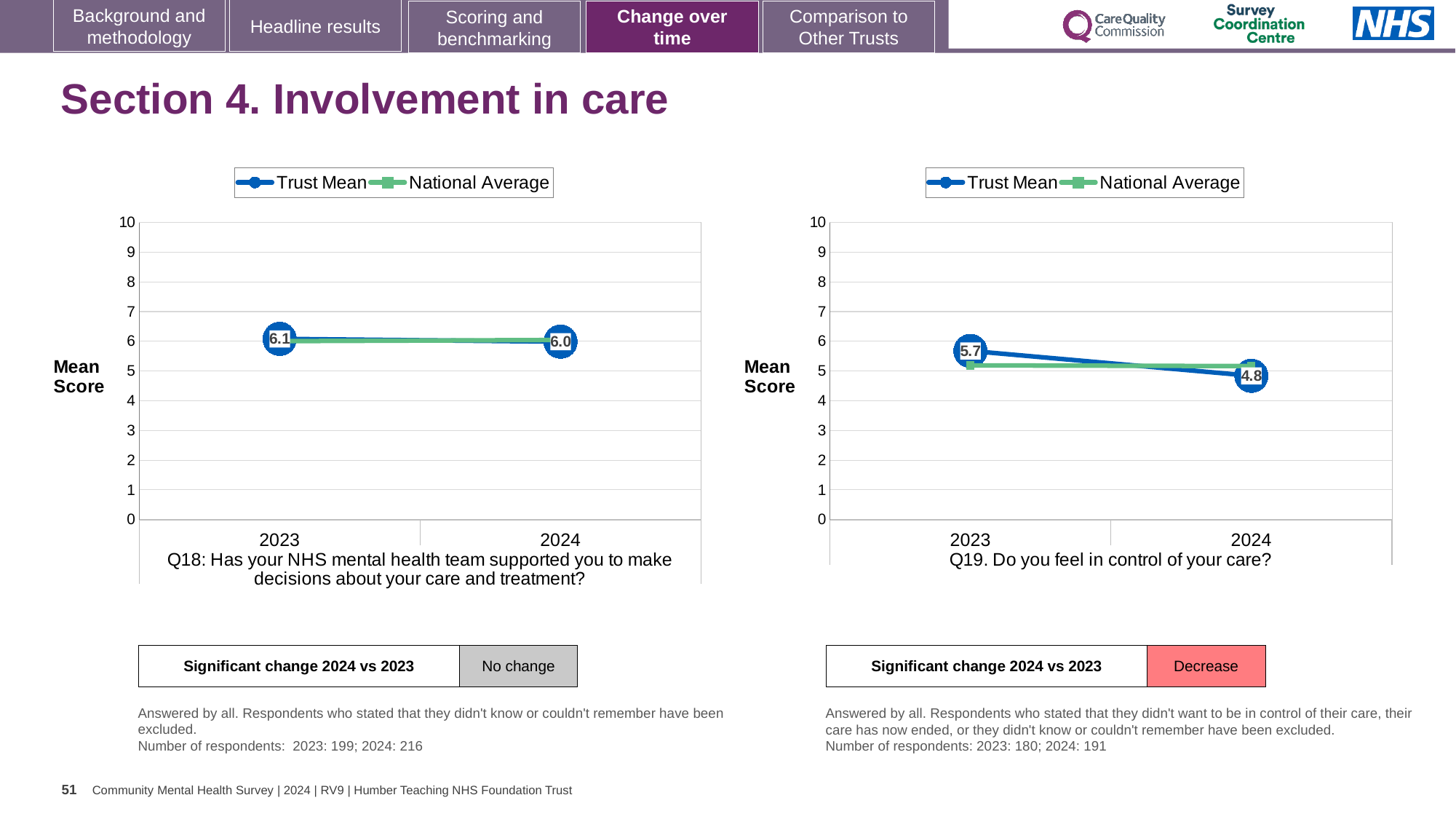
In the Q19 chart on the right, what is the Trust Mean for 2023? 5.7 In the Q19 chart on the right, which year has the higher Trust Mean, 2023 or 2024? 2023 In the Q18 chart on the left, what is the difference between the Trust Mean in 2023 and in 2024? 0.1 In the Q18 chart on the left, what is the Trust Mean for 2023? 6.1 In the Q19 chart on the right, what is the Trust Mean for 2024? 4.8 How many years are shown on the x axis of the Q18 chart on the left? 2 In the Q19 chart on the right, by how much did the Trust Mean fall from 2023 to 2024? 0.9 How many series does the legend of the Q19 chart on the right list? 2 What kind of chart is the Q18 chart on the left? line chart In the Q18 chart on the left, what is the Trust Mean for 2024? 6.0 In the Q19 chart on the right, is the Trust Mean for 2024 greater or less than 5? less In the Q19 chart on the right, does the Trust Mean rise or fall from 2023 to 2024? fall